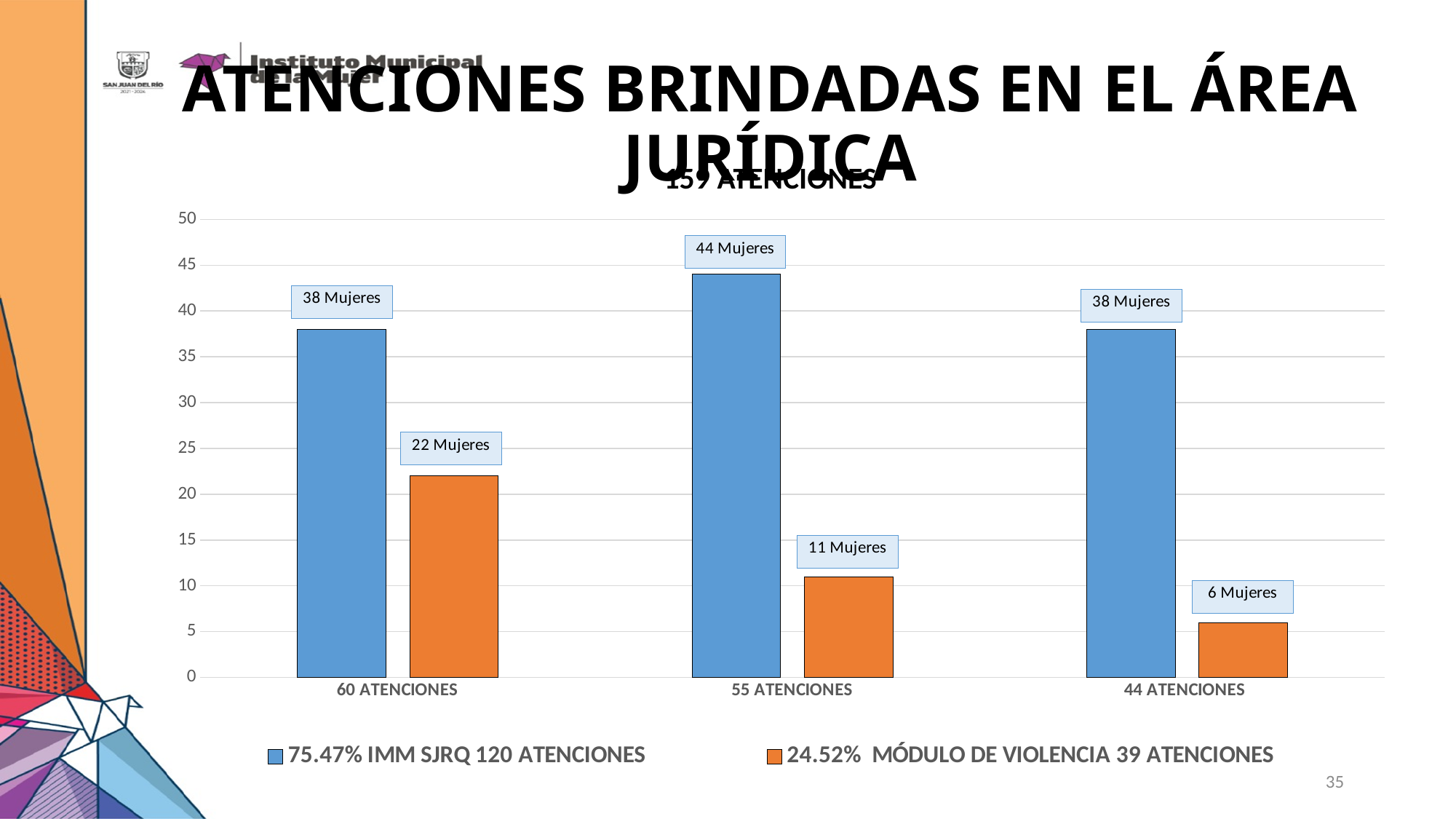
Is the MÓDULO DE VIOLENCIA value for '55 ATENCIONES' greater or less than 15? less What is the value of the MÓDULO DE VIOLENCIA series for the '60 ATENCIONES' category? 22 Mujeres How many series does the legend list? 2 How many categories are shown on the x axis? 3 What is the value of the IMM SJRQ series for the '55 ATENCIONES' category? 44 Mujeres What is the difference between the IMM SJRQ and MÓDULO DE VIOLENCIA values in the '55 ATENCIONES' category? 33 In which category is the IMM SJRQ series highest? 55 ATENCIONES In which category is the MÓDULO DE VIOLENCIA series lowest? 44 ATENCIONES What colour are the bars for the MÓDULO DE VIOLENCIA series? orange What type of chart is shown on the slide? bar chart What is the value of the MÓDULO DE VIOLENCIA series for the '44 ATENCIONES' category? 6 Mujeres Which is larger in the '60 ATENCIONES' category: the IMM SJRQ value or the MÓDULO DE VIOLENCIA value? IMM SJRQ